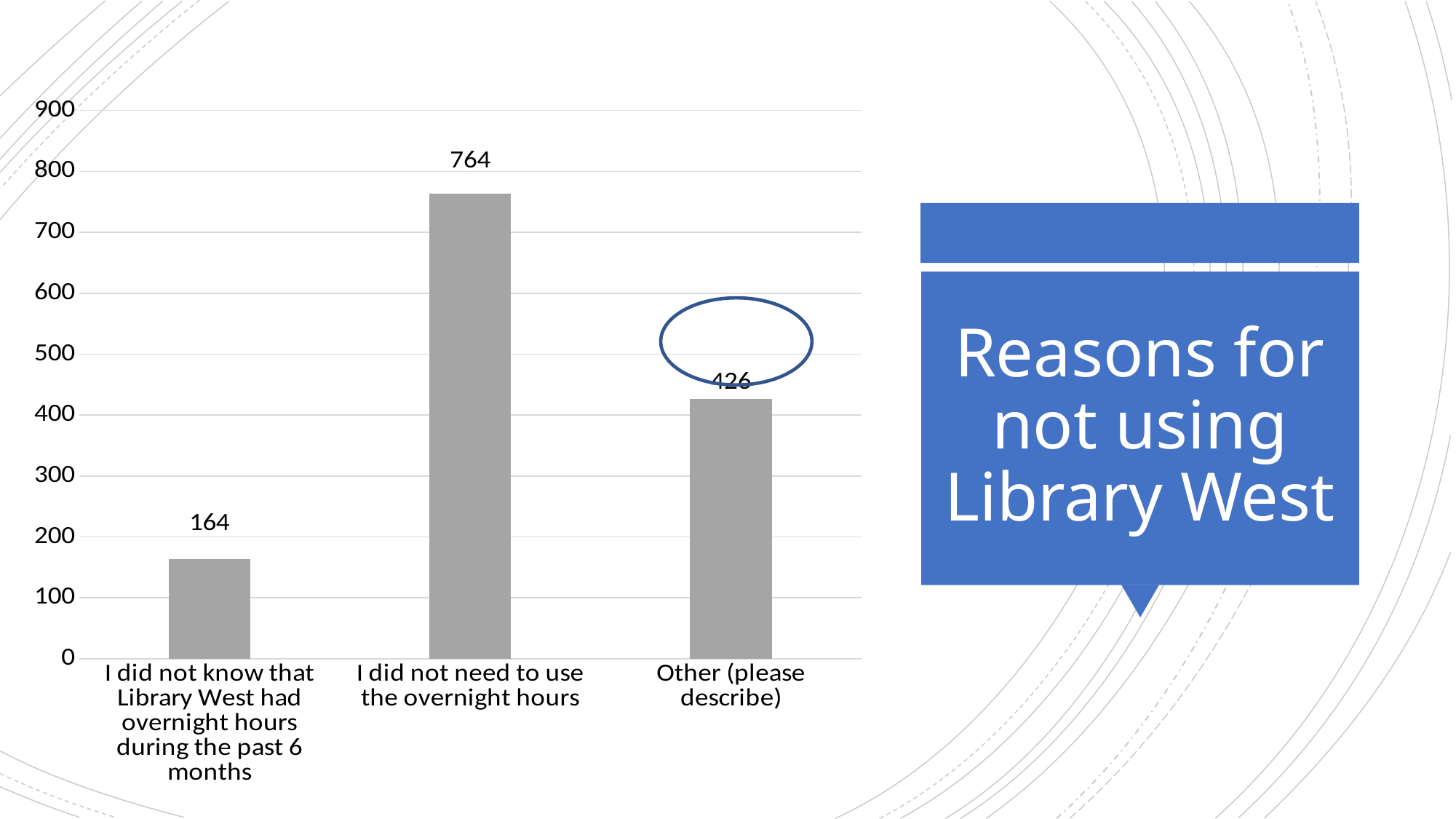
Which is larger: the value for "Other (please describe)" or the value for "I did not know that Library West had overnight hours during the past 6 months"? Other (please describe) What is the difference between the values for "I did not need to use the overnight hours" and "Other (please describe)"? 338 Which category has the highest value? I did not need to use the overnight hours Which category has the lowest value? I did not know that Library West had overnight hours during the past 6 months What is the value for "I did not need to use the overnight hours"? 764 What is the title shown in the blue callout box next to the chart? Reasons for not using Library West What is the difference between the values for "Other (please describe)" and "I did not know that Library West had overnight hours during the past 6 months"? 262 Is the value for "Other (please describe)" greater or less than 500? less How many categories are shown on the chart? 3 What kind of chart is shown on the slide? bar chart What is the value for "I did not know that Library West had overnight hours during the past 6 months"? 164 What is the value for "Other (please describe)"? 426